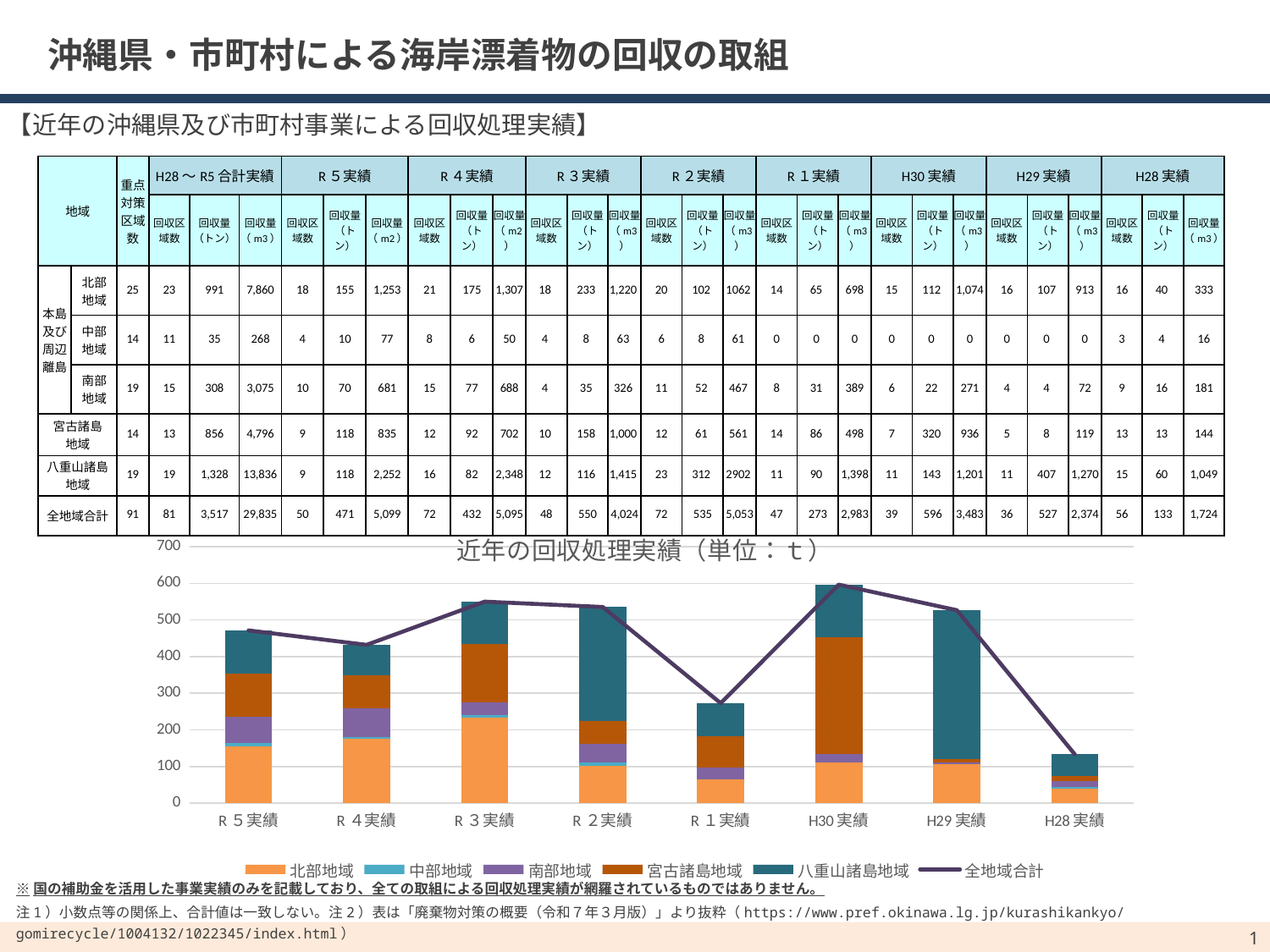
Using the table values, what is the difference between the 全地域合計 回収量 (トン) for H30実績 and H28実績? 463 Which fiscal year has the lowest 全地域合計 value in the chart? H28実績 What is the title of the chart on the slide? 近年の回収処理実績（単位：t） Is the 全地域合計 value for R1実績 greater or less than 300? less According to the table, what is the 全地域合計 回収量 (トン) for R5実績? 471 Does the 全地域合計 line fall or rise from H30実績 to H28実績? falls What kind of chart is shown on the slide? Stacked bar chart with a line Which is larger, the 全地域合計 value for H30実績 or for H29実績? H30実績 Which fiscal year has the highest 全地域合計 value in the chart? H30実績 How many series does the chart legend list? 6 Is the 全地域合計 value for R3実績 greater or less than 500? greater How many categories (fiscal years) are shown along the x axis of the chart? 8